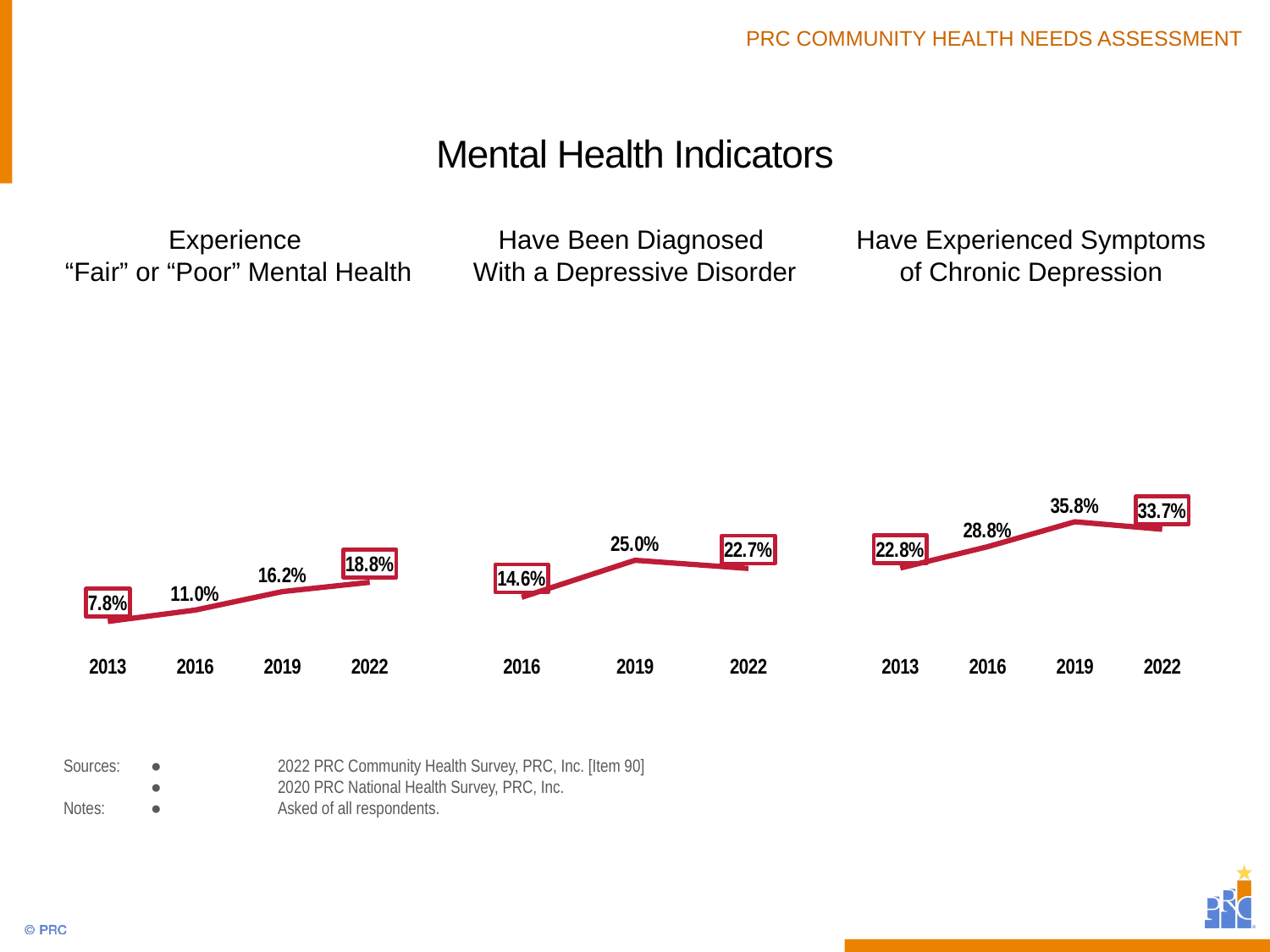
How many years are shown on the x axis of the "Have Experienced Symptoms of Chronic Depression" chart? 4 In the "Have Experienced Symptoms of Chronic Depression" chart, what is the value for 2019? 35.8% In the "Experience 'Fair' or 'Poor' Mental Health" chart, what is the value for 2022? 18.8% In the "Experience 'Fair' or 'Poor' Mental Health" chart, what is the difference between the 2022 and 2013 values? 11.0% How many data points are plotted in the "Have Been Diagnosed With a Depressive Disorder" chart? 3 In the "Experience 'Fair' or 'Poor' Mental Health" chart, do the values rise or fall from 2013 to 2022? Rise In the "Have Experienced Symptoms of Chronic Depression" chart, what is the difference between the 2019 and 2013 values? 13.0% What kind of chart is used for the "Experience 'Fair' or 'Poor' Mental Health" data? Line chart In the "Experience 'Fair' or 'Poor' Mental Health" chart, which year has the lowest value? 2013 In the "Have Been Diagnosed With a Depressive Disorder" chart, which is larger, the 2019 value or the 2022 value? 2019 In the "Have Been Diagnosed With a Depressive Disorder" chart, which year has the highest value? 2019 In the "Have Been Diagnosed With a Depressive Disorder" chart, what is the value for 2016? 14.6%